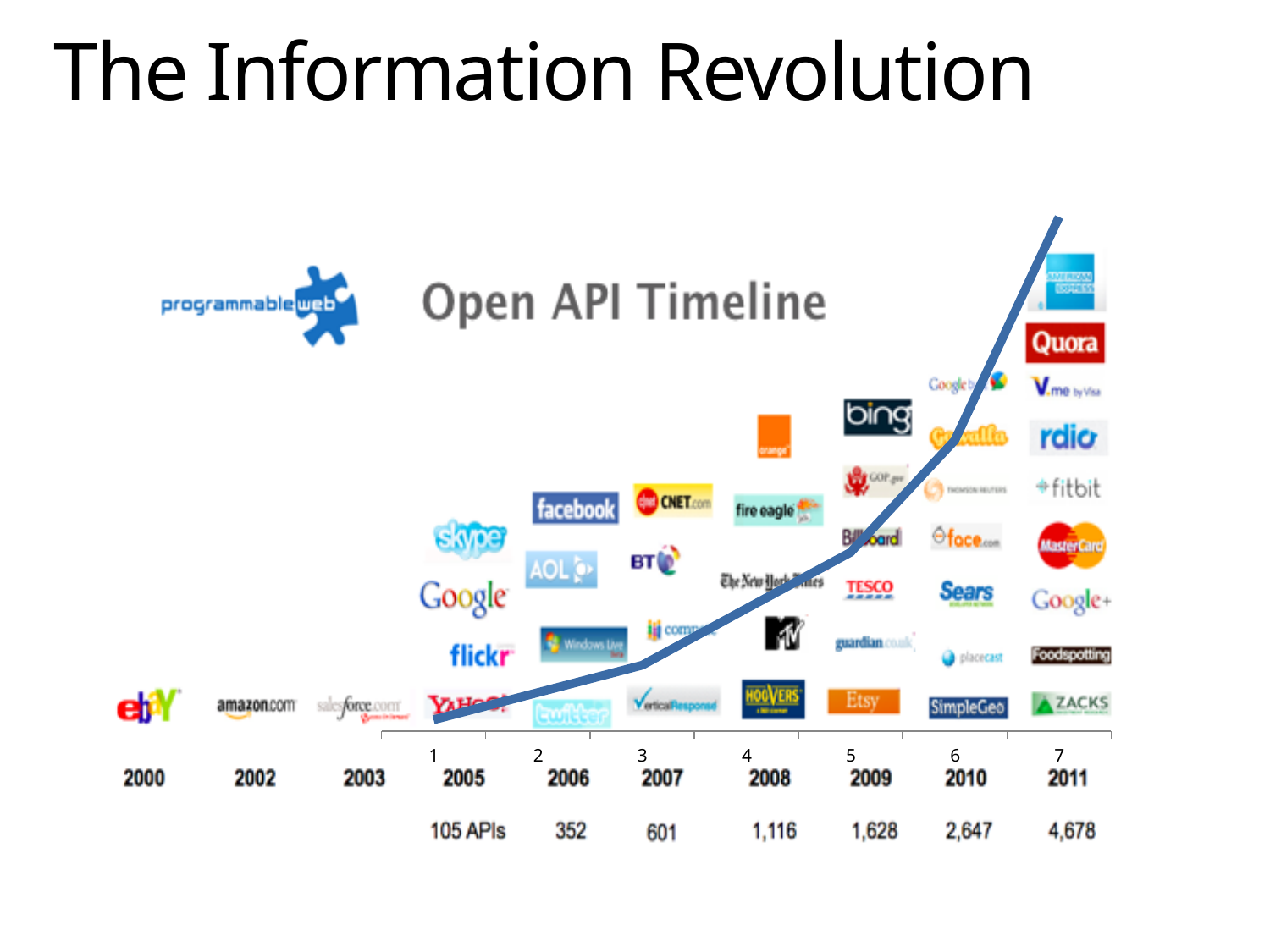
Which year has the lowest number of APIs among those with a count printed? 2005 How many points are plotted on the line chart (x-axis ticks 1 to 7)? 7 What is the number of APIs shown for 2010? 2,647 What is the difference in API count between 2011 and 2010? 2,031 Which year has the highest number of APIs on the timeline? 2011 What kind of chart is overlaid on the Open API Timeline image? line chart Does the line rise or fall from 2005 to 2011? rises What is the number of APIs shown for 2008? 1,116 How many APIs are listed for 2005 on the Open API Timeline? 105 APIs Which year has more APIs, 2007 or 2009? 2009 What is the title printed on the timeline image? Open API Timeline What is the number of APIs shown for 2011? 4,678